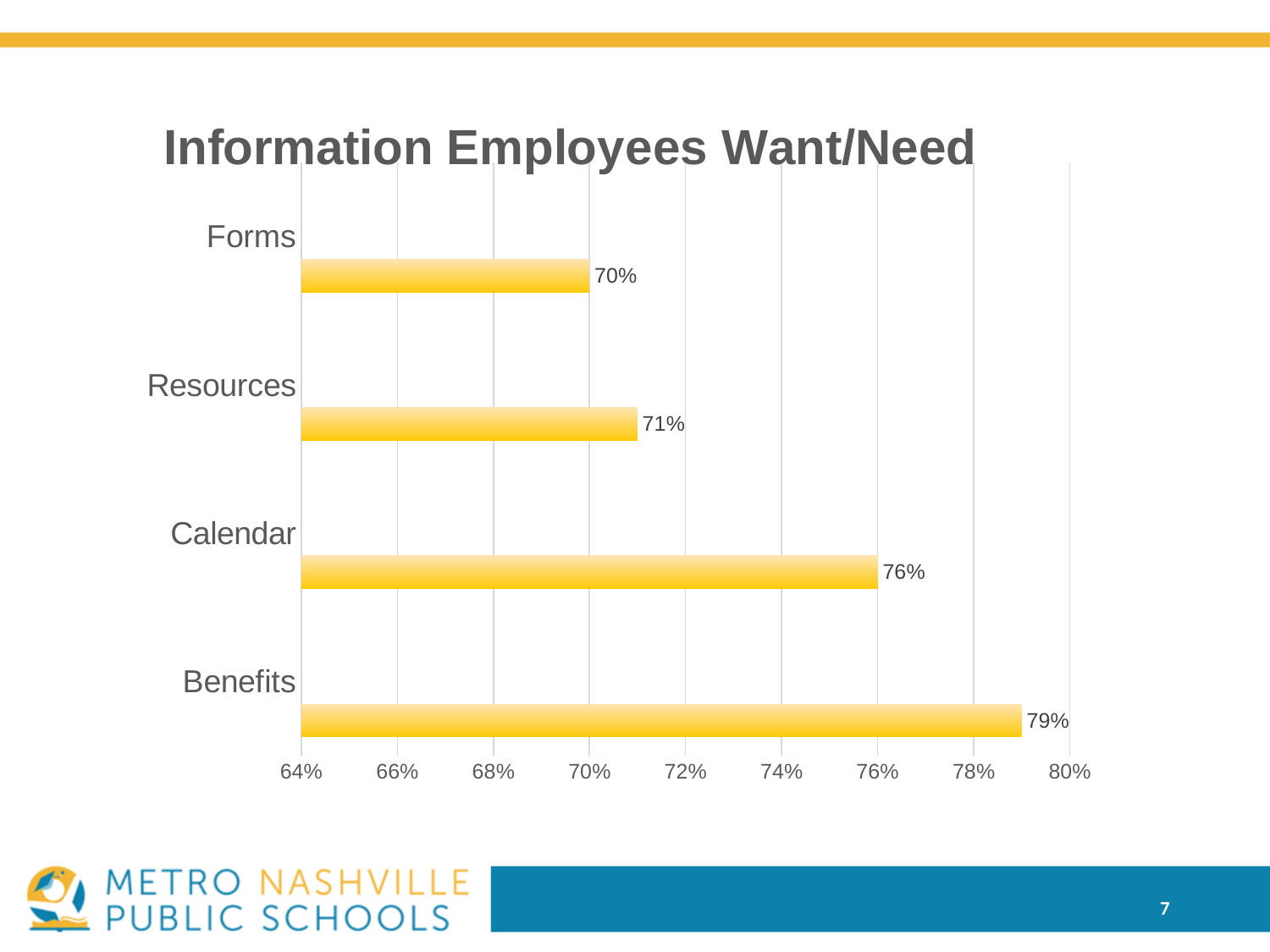
What is the value for Resources? 71% Is the value for Calendar greater or less than 74%? greater What is the value for Calendar? 76% Which category has the highest value? Benefits What is the difference between the values for Benefits and Forms? 9% How many categories are shown in the chart? 4 What kind of chart is shown on the slide? Bar chart What is the value for Benefits? 79% Which category has the lowest value? Forms What is the value for Forms? 70% Which is larger, the value for Calendar or the value for Resources? Calendar What is the difference between the values for Calendar and Resources? 5%